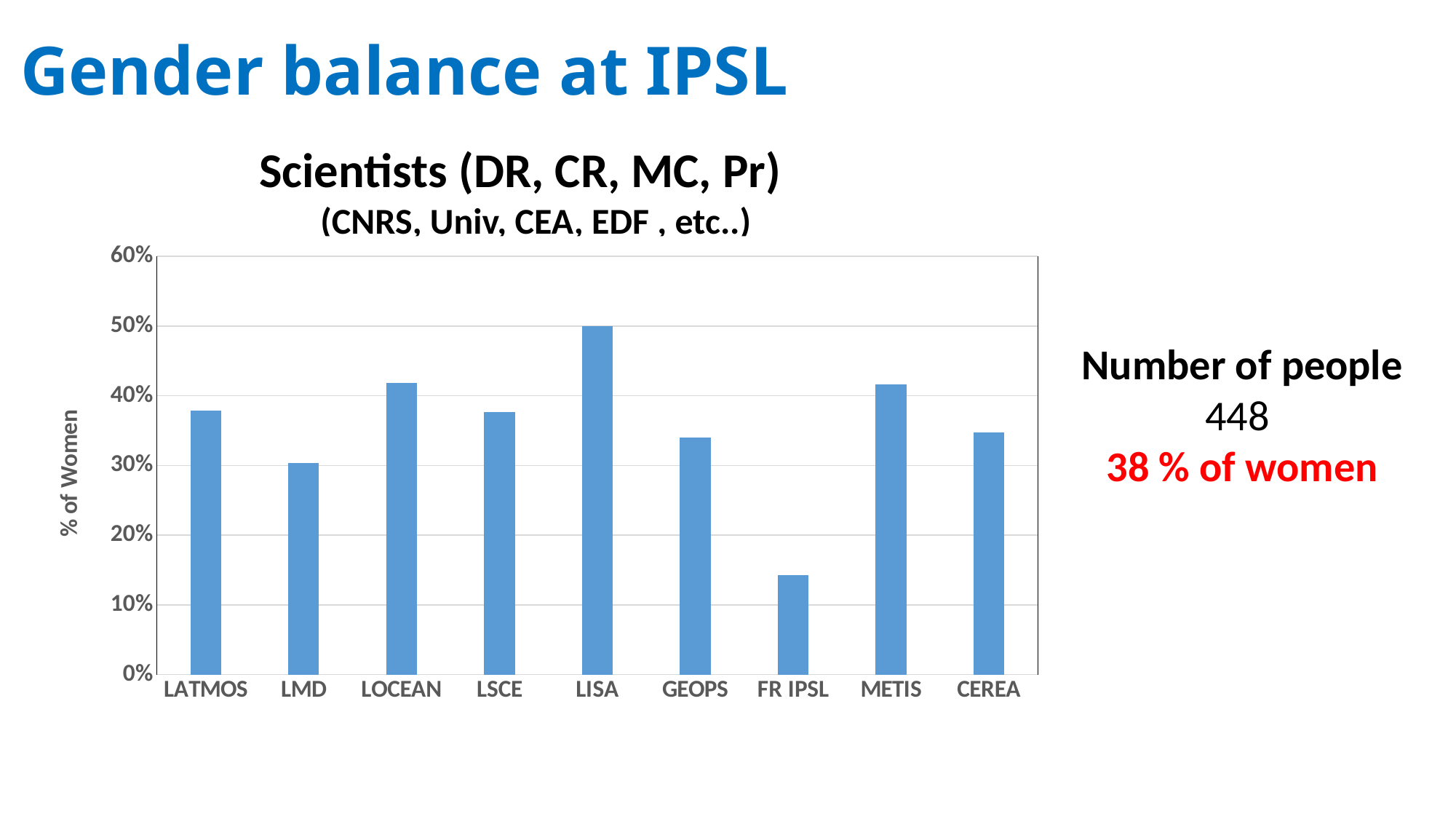
What is the percentage of women for LISA? 50% How many laboratories (categories) are shown on the x axis of the chart? 9 Is the value for LATMOS greater or less than 40%? less Is the value for LOCEAN greater or less than 40%? greater What kind of chart is shown on the slide? bar chart What is the label on the y axis of the chart? % of Women Which laboratory has the lowest percentage of women among scientists? FR IPSL Which has a higher percentage of women, CEREA or FR IPSL? CEREA Is the value for GEOPS greater or less than 30%? greater Which has a higher percentage of women, LOCEAN or LMD? LOCEAN Which laboratory has the highest percentage of women among scientists? LISA